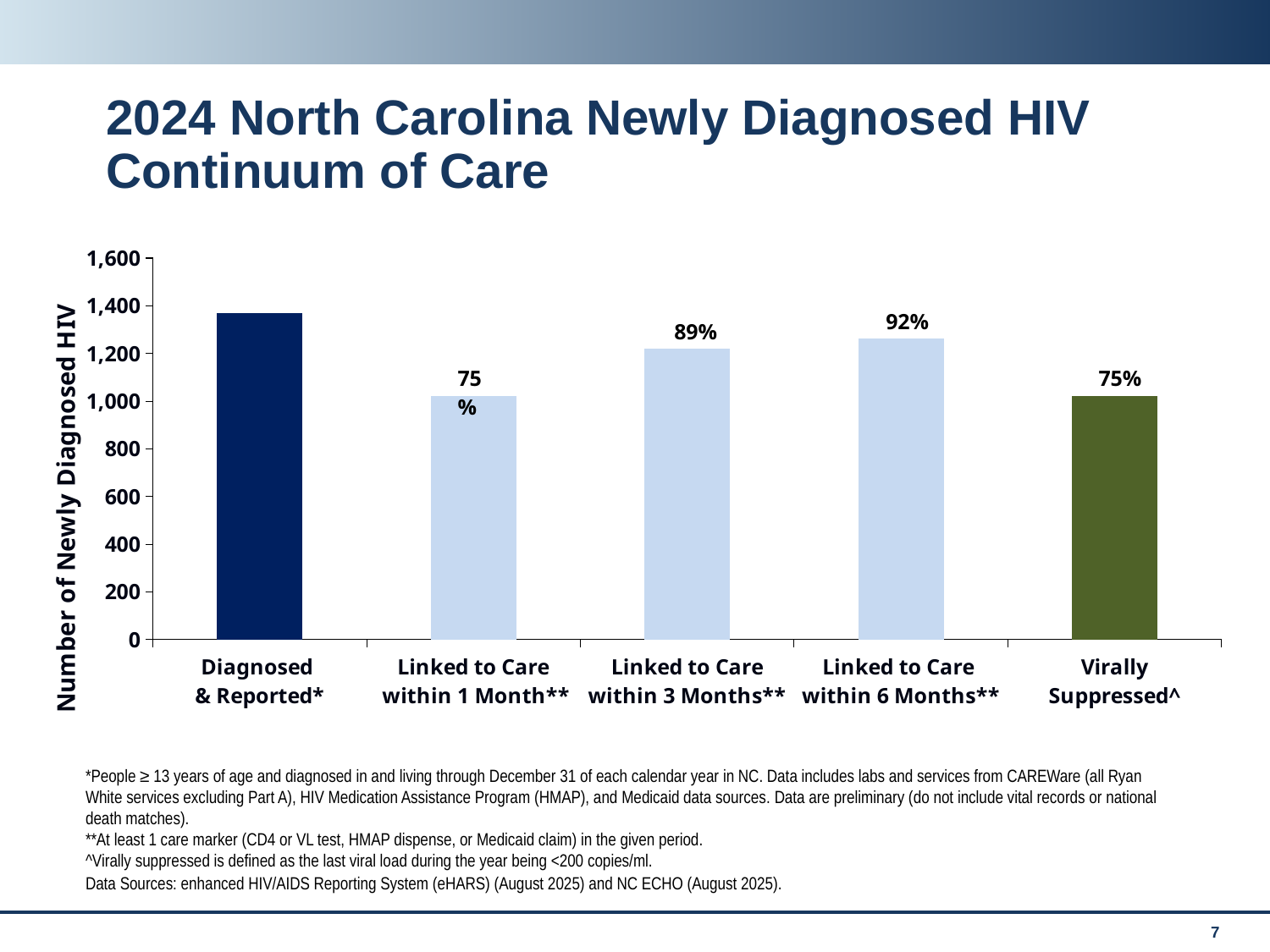
Is the value for Linked to Care within 6 Months greater or less than 1,200? greater What percentage label is shown above the bar for Linked to Care within 3 Months? 89% Is the value for Linked to Care within 1 Month greater or less than 1,200? less What kind of chart is shown on the slide? bar chart What is the title of the y axis of the chart? Number of Newly Diagnosed HIV Which bar is taller: Diagnosed & Reported or Linked to Care within 1 Month? Diagnosed & Reported What percentage label is shown above the bar for Linked to Care within 6 Months? 92% What percentage label is shown above the bar for Virally Suppressed? 75% Is the value for Diagnosed & Reported greater or less than 1,200? greater Which category has the tallest bar in the chart? Diagnosed & Reported How many categories are shown on the x axis of the chart? 5 What percentage label is shown above the bar for Linked to Care within 1 Month? 75%